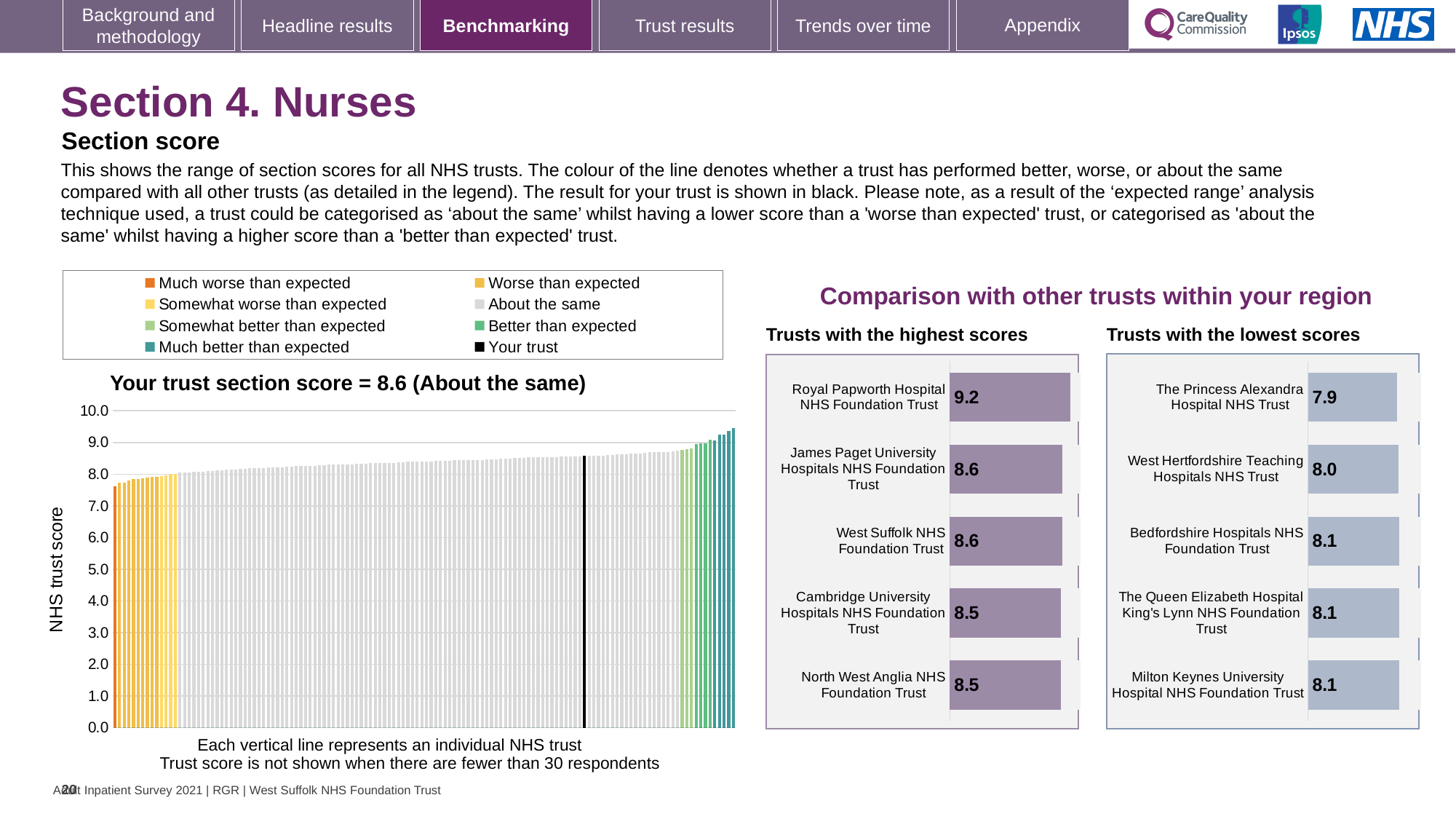
How many trusts are shown in the 'Trusts with the highest scores' chart? 5 In the 'Trusts with the lowest scores' chart, which trust has the lowest score? The Princess Alexandra Hospital NHS Trust What kind of chart is the main chart on the left showing the range of section scores for all NHS trusts? bar chart In the main chart on the left showing the range of section scores, what is the section score for your trust? 8.6 In the 'Trusts with the lowest scores' chart, what is the score for The Princess Alexandra Hospital NHS Trust? 7.9 In the 'Trusts with the highest scores' chart, what is the score for Royal Papworth Hospital NHS Foundation Trust? 9.2 In the 'Trusts with the lowest scores' chart, which has the larger score: West Hertfordshire Teaching Hospitals NHS Trust or The Princess Alexandra Hospital NHS Trust? West Hertfordshire Teaching Hospitals NHS Trust In the 'Trusts with the lowest scores' chart, what is the difference between the scores of Milton Keynes University Hospital NHS Foundation Trust and The Princess Alexandra Hospital NHS Trust? 0.2 In the 'Trusts with the highest scores' chart, what is the difference between the scores of Royal Papworth Hospital NHS Foundation Trust and North West Anglia NHS Foundation Trust? 0.7 In the 'Trusts with the highest scores' chart, which trust has the highest score? Royal Papworth Hospital NHS Foundation Trust How many entries does the legend above the main chart on the left list? 8 In the main chart on the left, do the trust scores rise or fall from left to right along the x axis? rise